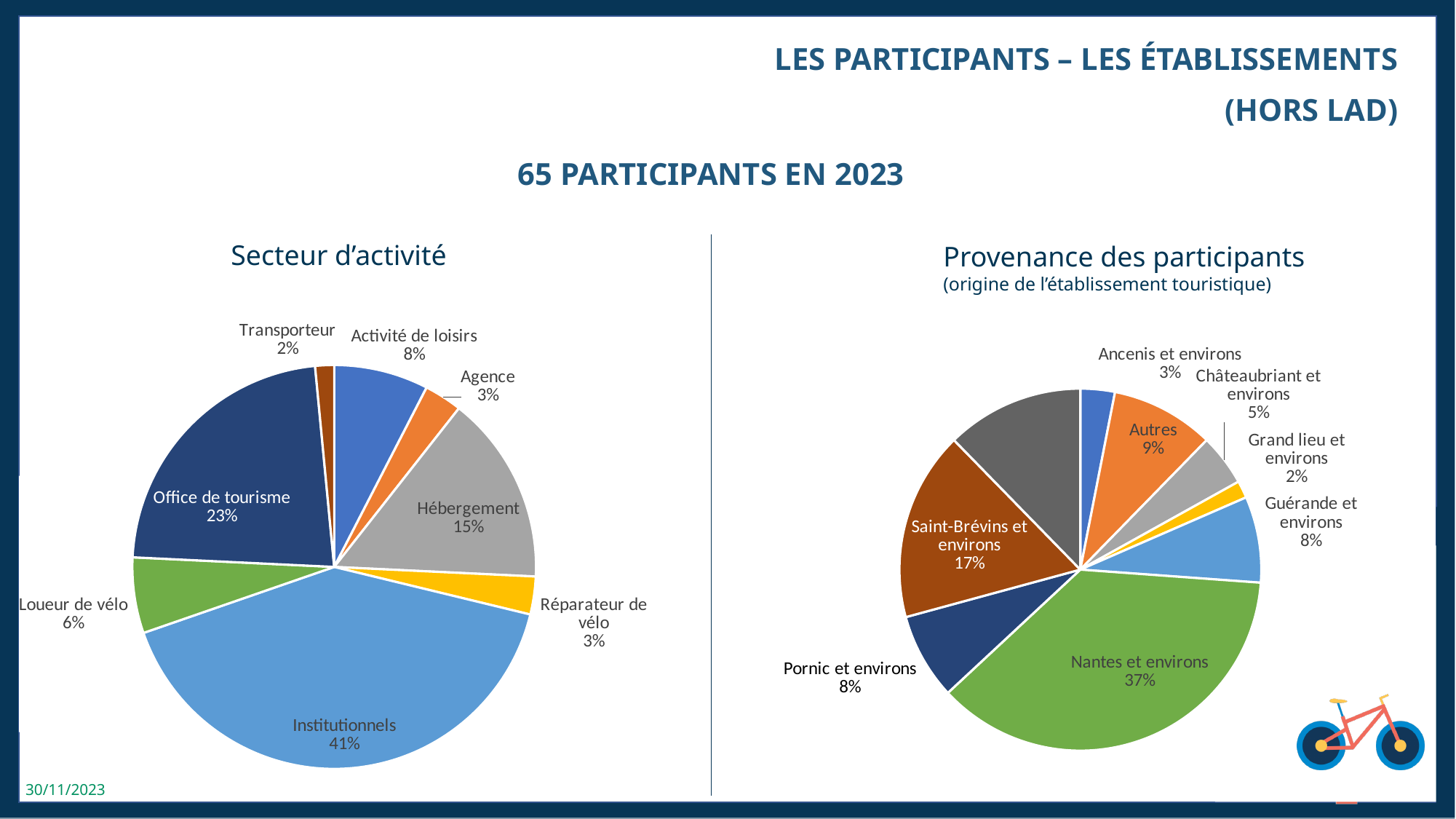
In the 'Secteur d'activité' pie chart, what share is Institutionnels? 41% In the 'Secteur d'activité' pie chart, what is the difference between the shares of Hébergement and Loueur de vélo? 9 percentage points In the 'Provenance des participants' pie chart, which origin has the largest share? Nantes et environs In the 'Provenance des participants' pie chart, which is larger: Autres or Châteaubriant et environs? Autres In the 'Secteur d'activité' pie chart, what share is Office de tourisme? 23% In the 'Secteur d'activité' pie chart, which sector has the smallest share? Transporteur What is the subtitle shown under the title 'Provenance des participants'? (origine de l'établissement touristique) In the 'Secteur d'activité' pie chart, which sector has the largest share? Institutionnels In the 'Secteur d'activité' pie chart, how many sectors are shown? 8 In the 'Provenance des participants' pie chart, what share is Saint-Brévins et environs? 17% In the 'Provenance des participants' pie chart, what share is Nantes et environs? 37% What kind of chart is 'Provenance des participants'? Pie chart